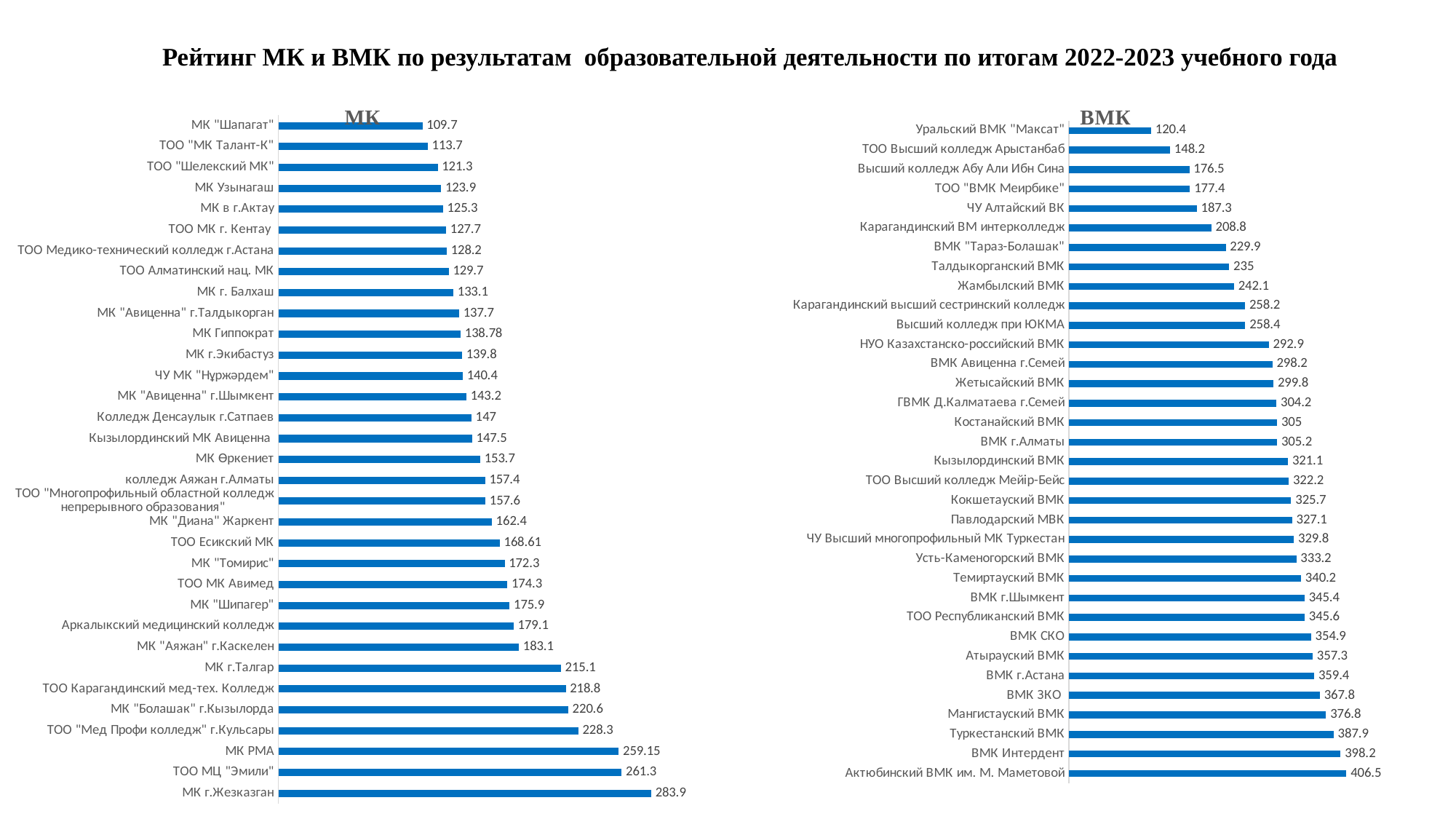
In the ВМК chart, what is the difference between ВМК Интердент and Туркестанский ВМК? 10.3 In the ВМК chart, which category has the lowest value? Уральский ВМК "Максат" In the МК chart, what is the value for МК г.Жезказган? 283.9 In the МК chart, which category has the highest value? МК г.Жезказган In the ВМК chart, what is the value for Актюбинский ВМК им. М. Маметовой? 406.5 In the МК chart, what is the difference between ТОО МЦ "Эмили" and МК РМА? 2.15 In the МК chart, which category has the lowest value? МК "Шапагат" In the ВМК chart, which is larger: Жамбылский ВМК or ВМК "Тараз-Болашак"? Жамбылский ВМК In the МК chart, what is the value for МК Гиппократ? 138.78 What type of chart is the ВМК chart? bar chart In the ВМК chart, what is the value for Талдыкорганский ВМК? 235 In the МК chart, which is larger: МК г.Талгар or МК "Аяжан" г.Каскелен? МК г.Талгар